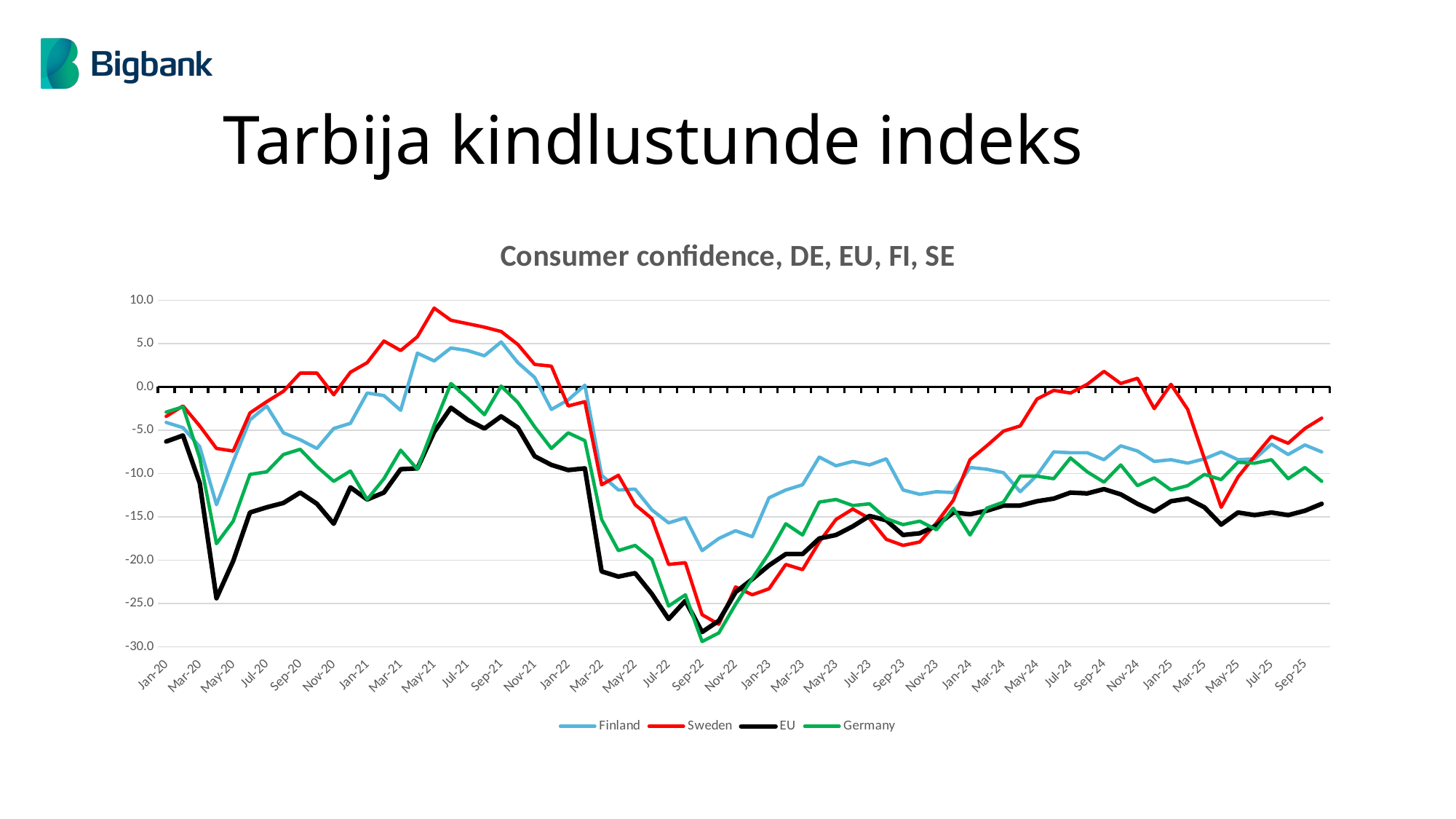
Which colour is used for the Sweden series? red Which series reaches the highest value anywhere on the chart? Sweden Is the value for Finland in Sep-22 greater or less than -15.0? less How many series does the legend list? 4 Is the value for Sweden in May-21 greater or less than 5.0? greater In May-20, which series has the lower value, EU or Finland? EU What kind of chart is shown on the slide? line chart Does the Sweden series rise or fall between Jan-25 and Apr-25? fall What is the title of the chart? Consumer confidence, DE, EU, FI, SE Is the value for Germany in Sep-22 greater or less than -25.0? less In May-21, which series has the higher value, Sweden or EU? Sweden